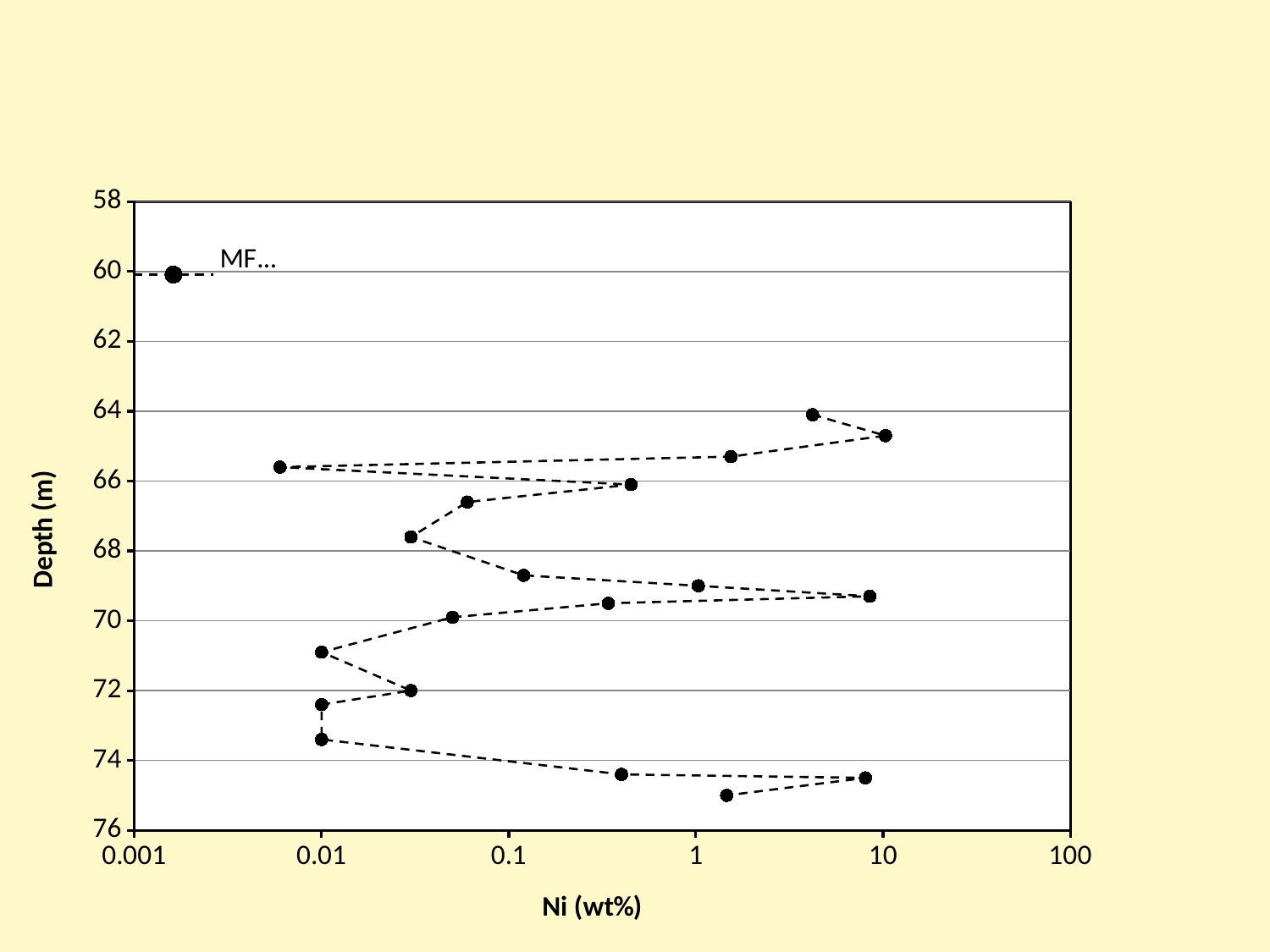
Is the Ni value of the data point just below the 70 m gridline (the one nearest 0.1) greater or less than 0.1? less Is the Ni value of the data point just above the 64 m gridline greater or less than 1? greater Is the Ni value of the data point lying on the 72 m gridline greater or less than 0.01? greater What kind of chart is shown on the slide? scatter chart What is the title of the y axis? Depth (m) What is the title of the x axis? Ni (wt%)